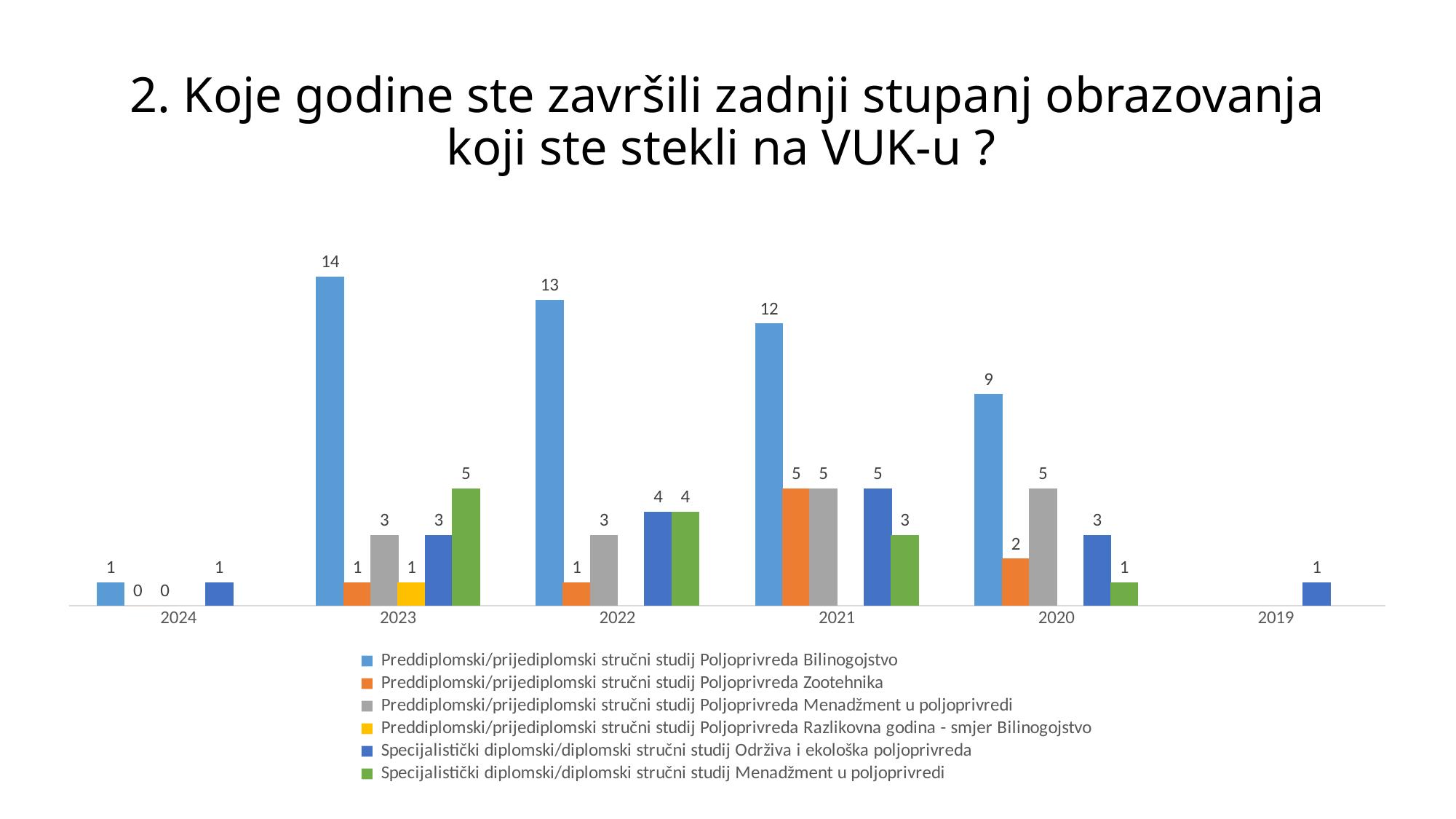
In which year is the value for Specijalistički diplomski/diplomski stručni studij Menadžment u poljoprivredi highest? 2023 Do the values for Preddiplomski/prijediplomski stručni studij Poljoprivreda Bilinogojstvo rise or fall from 2023 to 2020 along the x axis? fall How many years are shown on the x axis? 6 What is the value for Preddiplomski/prijediplomski stručni studij Poljoprivreda Bilinogojstvo in 2023? 14 What is the difference between the Preddiplomski/prijediplomski stručni studij Poljoprivreda Bilinogojstvo values for 2021 and 2020? 3 What kind of chart is shown on the slide? bar chart What is the value for Preddiplomski/prijediplomski stručni studij Poljoprivreda Zootehnika in 2021? 5 What is the value for Specijalistički diplomski/diplomski stručni studij Menadžment u poljoprivredi in 2023? 5 Which is larger: the Specijalistički diplomski/diplomski stručni studij Održiva i ekološka poljoprivreda value for 2022 or for 2020? 2022 In which year is the value for Preddiplomski/prijediplomski stručni studij Poljoprivreda Bilinogojstvo highest? 2023 How many series does the legend list? 6 What is the value for Specijalistički diplomski/diplomski stručni studij Održiva i ekološka poljoprivreda in 2019? 1